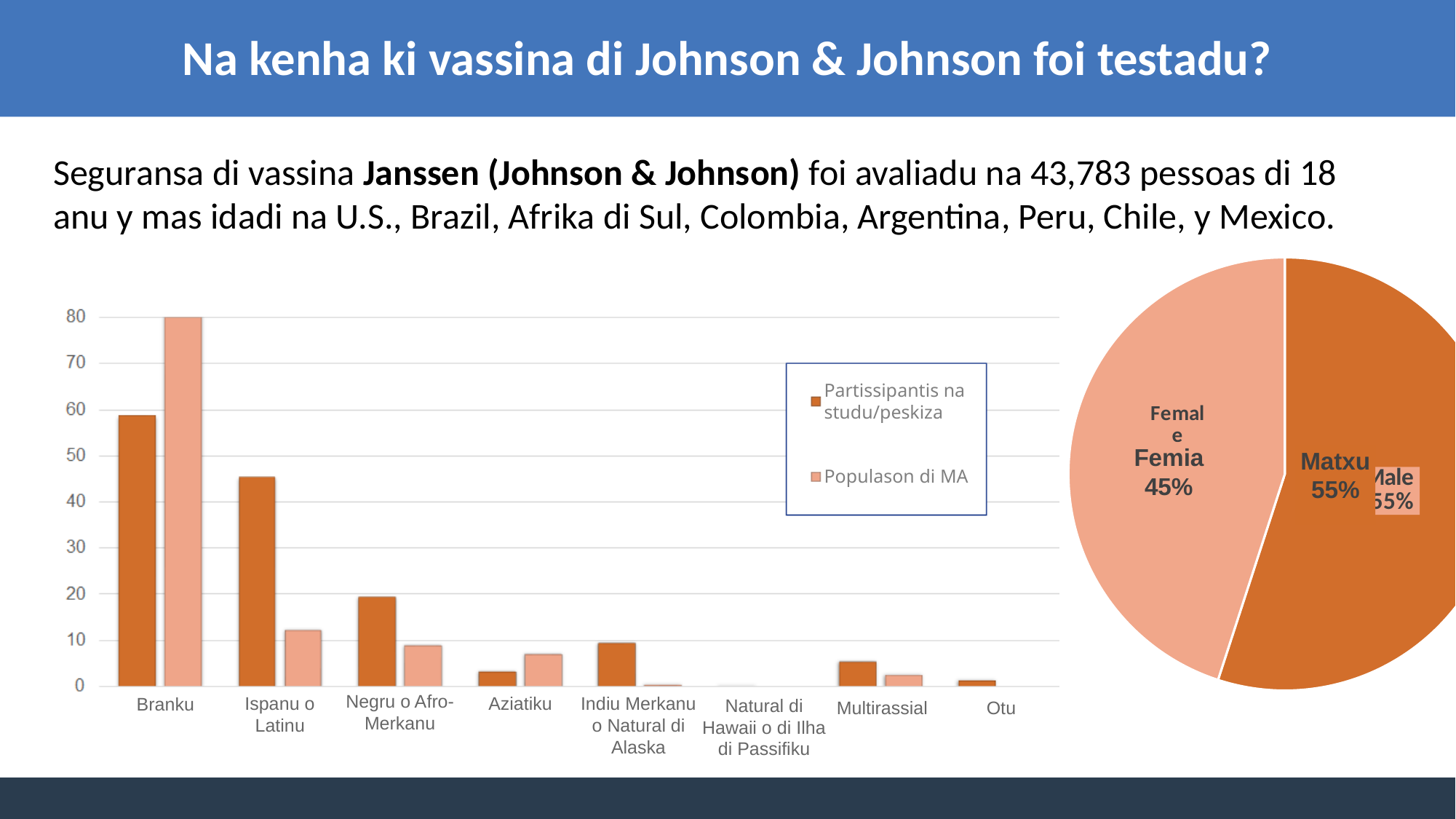
In the pie chart on the right, which slice is larger: Femia or Matxu? Matxu In the bar chart on the left, how many series does the legend list? 2 What kind of chart is the chart on the right of the slide? pie chart In the bar chart on the left, which category has the highest value for Populason di MA? Branku What kind of chart is the chart on the left of the slide? bar chart In the pie chart on the right, what share of the pie is Femia? 45% In the pie chart on the right, what share of the pie is Matxu? 55% In the bar chart on the left, for Negru o Afro-Merkanu, which series has the larger value: Partissipantis na studu/peskiza or Populason di MA? Partissipantis na studu/peskiza In the bar chart on the left, which category has the highest value for Partissipantis na studu/peskiza? Branku In the bar chart on the left, is the Populason di MA value for Ispanu o Latinu greater or less than 20? less In the bar chart on the left, is the Partissipantis na studu/peskiza value for Branku greater or less than 50? greater In the bar chart on the left, how many categories are shown on the x axis? 8